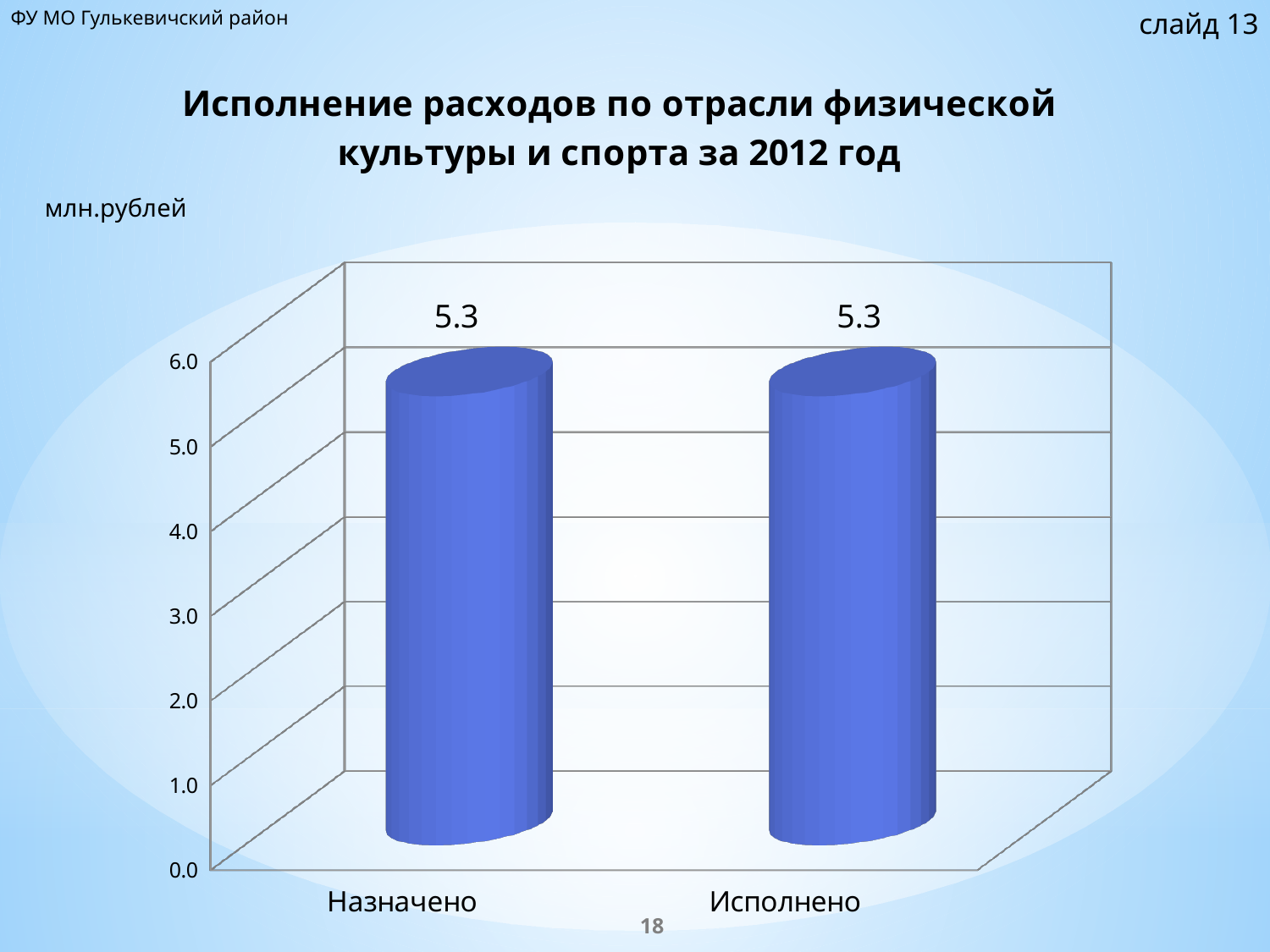
What is the difference between the values for Назначено and Исполнено? 0 What unit of measurement is indicated for the chart values? млн.рублей How many categories are shown on the x axis? 2 Is the value for Исполнено greater or less than 6.0? less What is the title of the chart? Исполнение расходов по отрасли физической культуры и спорта за 2012 год What kind of chart is shown on the slide? bar chart What is the value for Назначено? 5.3 What is the value for Исполнено? 5.3 Is the value for Назначено greater or less than 5.0? greater What is the maximum value shown on the y axis? 6.0